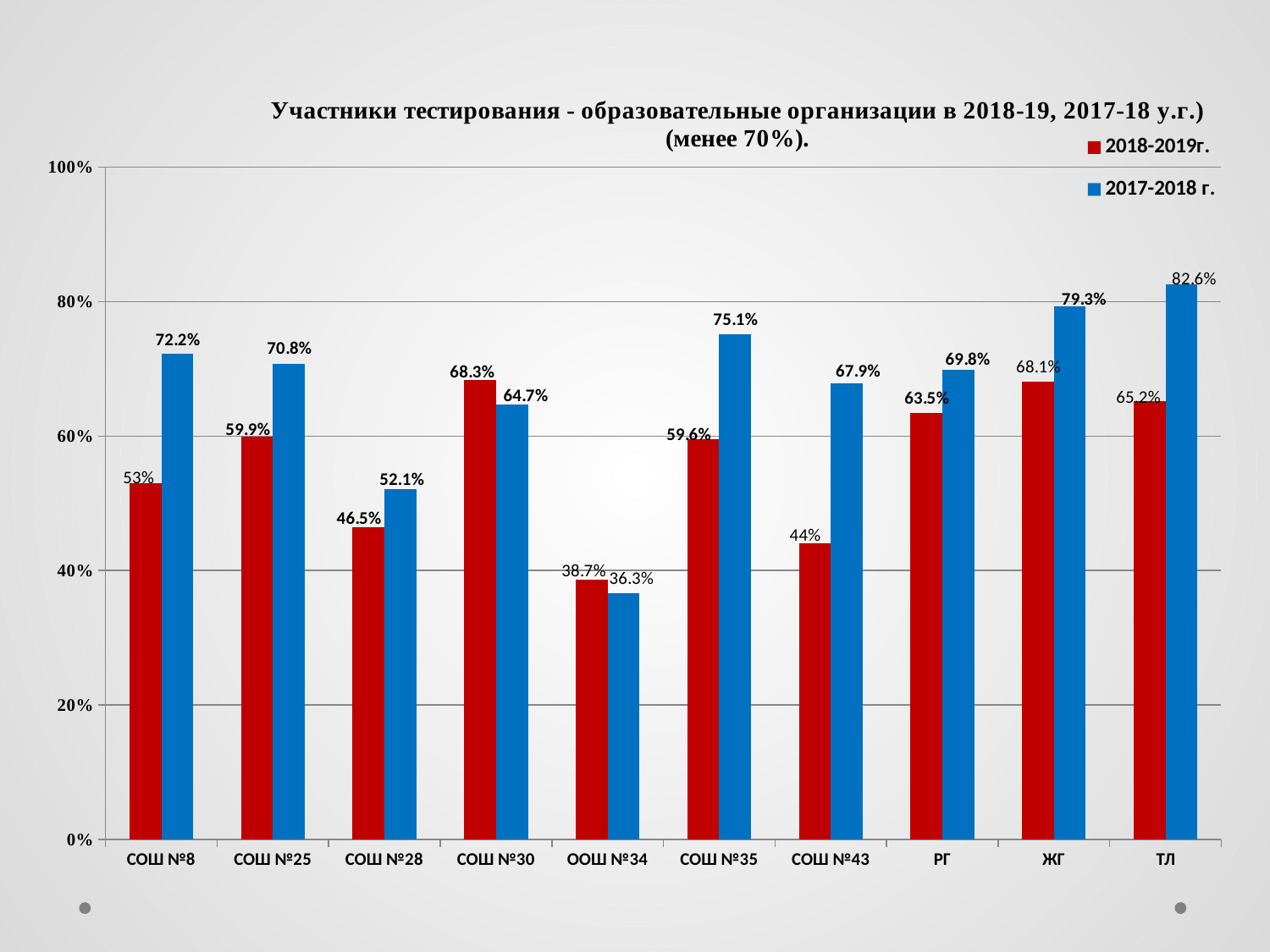
What is the difference between the 2017-2018 г. and 2018-2019г. values for СОШ №8? 19.2% What kind of chart is shown on the slide? bar chart What is the difference between the 2017-2018 г. and 2018-2019г. values for СОШ №43? 23.9% Is the 2017-2018 г. value for СОШ №35 greater or less than 60%? greater What is the value for ТЛ in the 2017-2018 г. series? 82.6% What is the value for СОШ №8 in the 2018-2019г. series? 53% How many series does the legend list? 2 Which category has the lowest value in the 2018-2019г. series? ООШ №34 Which category has the highest value in the 2017-2018 г. series? ТЛ For СОШ №30, which series has the larger value: 2018-2019г. or 2017-2018 г.? 2018-2019г. What is the value for СОШ №43 in the 2017-2018 г. series? 67.9% How many categories are shown on the x axis? 10